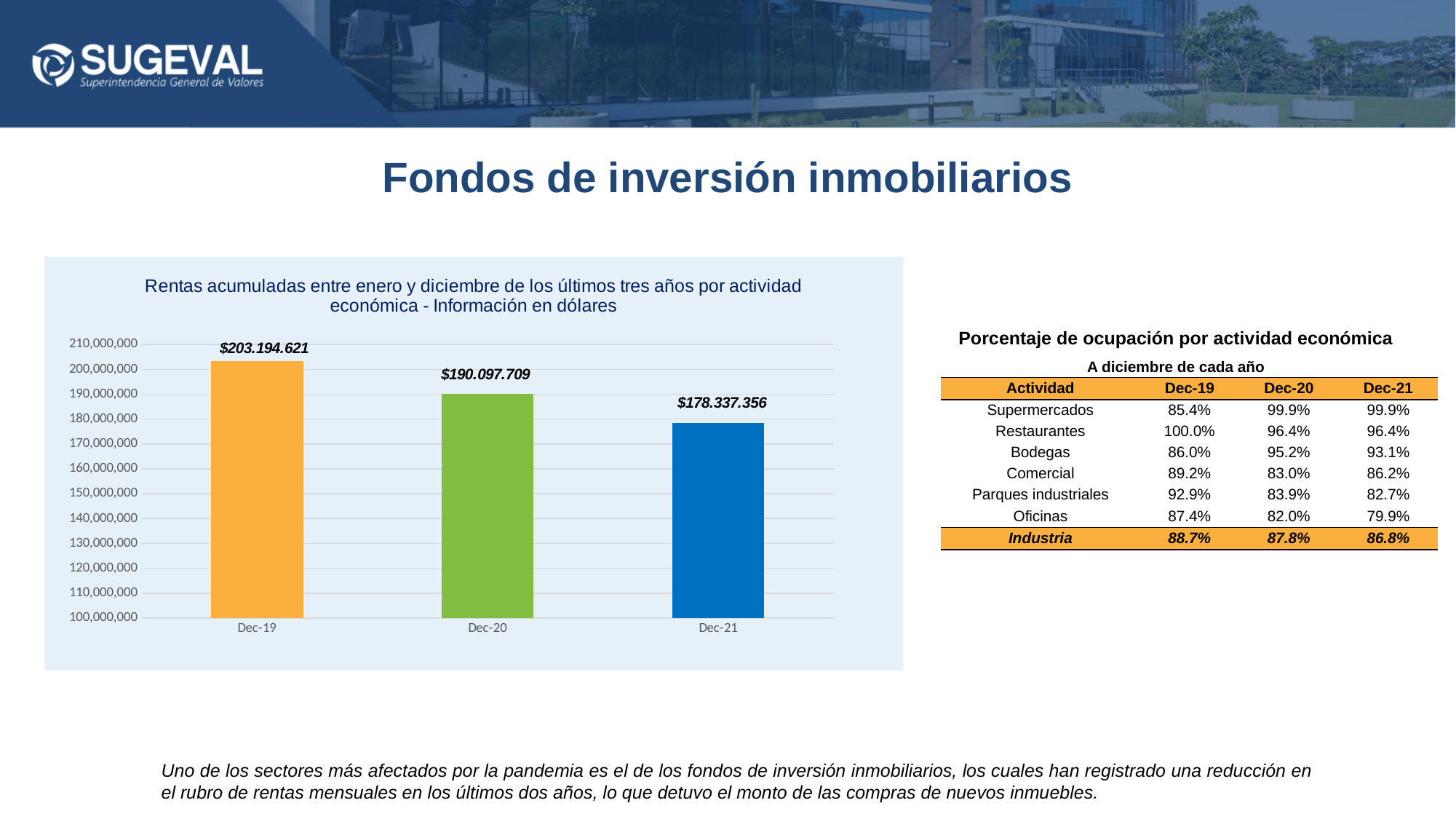
What is the difference between the Dec-19 and Dec-20 values in the chart? $13.096.912 What kind of chart is shown on the slide? bar chart What is the difference between the Dec-20 and Dec-21 values in the chart? $11.760.353 What is the value shown for Dec-20 in the chart? $190.097.709 What is the value shown for Dec-19 in the chart? $203.194.621 Which period has the lowest value in the chart? Dec-21 Is the value for Dec-21 greater or less than 170,000,000? greater Which period has the highest value in the chart? Dec-19 Which is larger in the chart, the value for Dec-20 or the value for Dec-21? Dec-20 How many bars are plotted in the chart? 3 What is the value shown for Dec-21 in the chart? $178.337.356 Do the values in the chart rise or fall from Dec-19 to Dec-21? fall